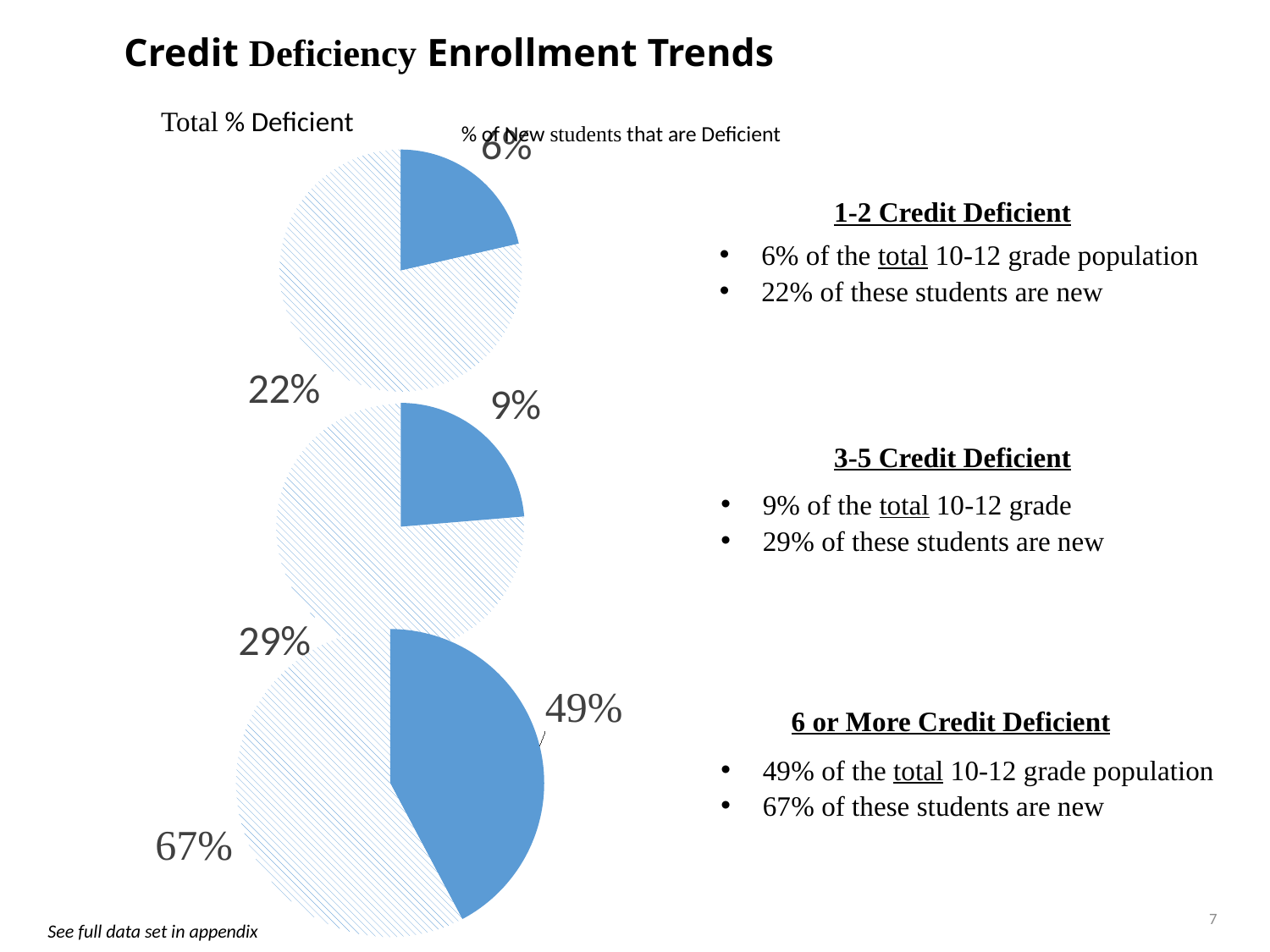
According to the heading above the pie charts, what does the solid blue slice represent? Total % Deficient In the bottom pie chart, what value is labelled on the solid blue slice? 49% In the bottom pie chart, which labelled value is larger, 49% or 67%? 67% In the middle pie chart, what value is labelled on the hatched slice? 29% In the bottom pie chart, what is the difference between the 67% label and the 49% label? 18 percentage points In the top pie chart, what value is labelled on the solid blue slice? 6% In the bottom pie chart, what value is labelled on the hatched slice? 67% What kind of charts are shown on the slide? Pie charts Which of the three pie charts has the largest solid blue slice? The bottom pie chart How many pie charts are on the slide? 3 In the top pie chart, what value is labelled on the hatched slice? 22% In the middle pie chart, what value is labelled on the solid blue slice? 9%